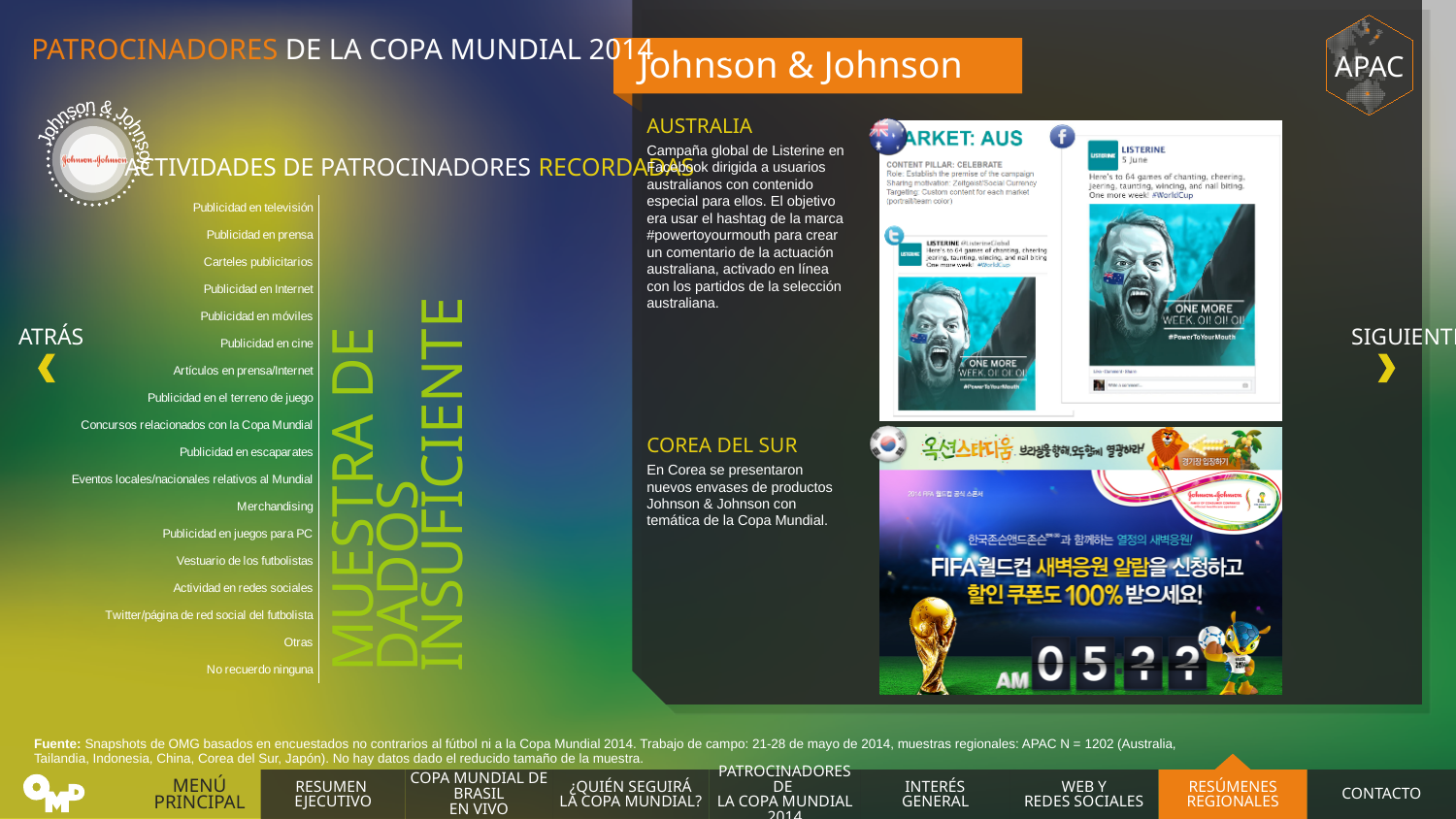
What is the last category listed at the bottom of the chart's axis? No recuerdo ninguna How many categories are listed on the chart's axis? 18 What is the first category listed at the top of the chart's axis? Publicidad en televisión What message is printed across the chart area instead of plotted data? MUESTRA DE DATOS INSUFICIENTE What is the title of the chart on the slide? ACTIVIDADES DE PATROCINADORES RECORDADAS